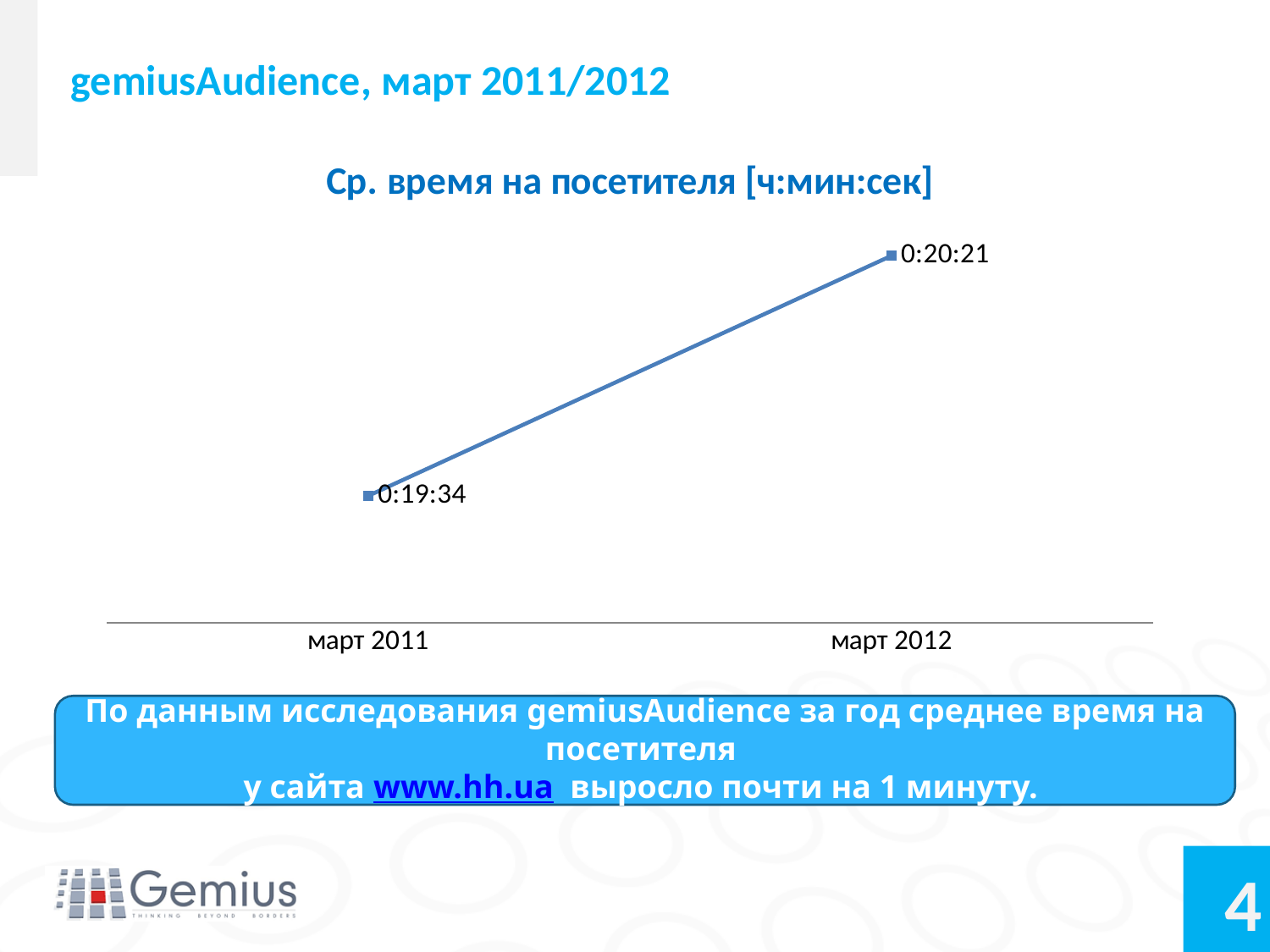
How many data points are plotted on the chart? 2 Is the value for март 2012 larger or smaller than the value for март 2011? larger Does the average time per visitor rise or fall from март 2011 to март 2012? rise What is the average time per visitor for март 2011? 0:19:34 Which period has the lower average time per visitor? март 2011 What is the average time per visitor for март 2012? 0:20:21 What is the title of the chart? Ср. время на посетителя [ч:мин:сек] In what units are the chart values given, according to the title? ч:мин:сек Which period has the higher average time per visitor? март 2012 By how much did the average time per visitor increase from март 2011 to март 2012? 47 seconds What kind of chart is shown on the slide? line chart